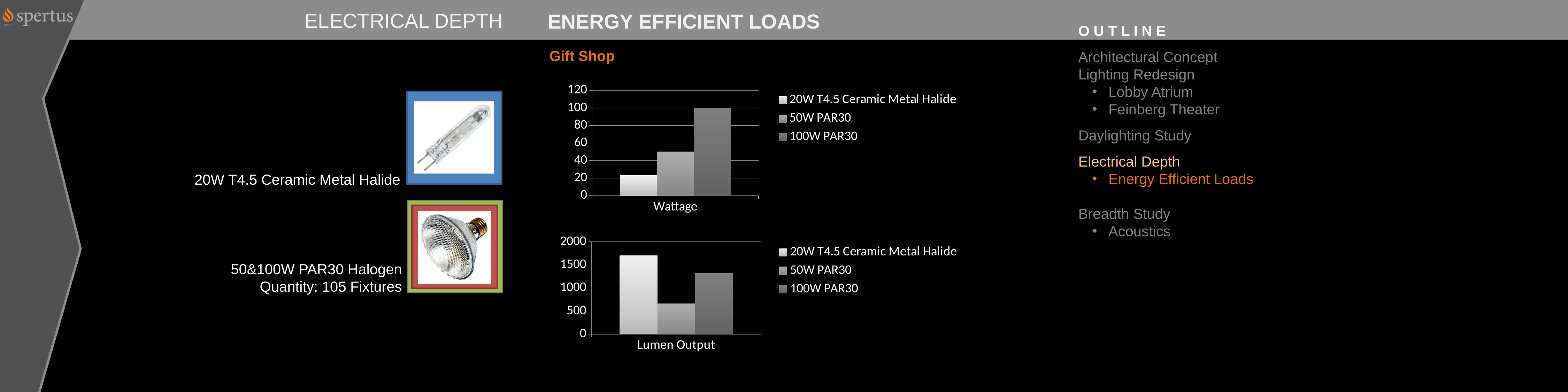
In the Lumen Output chart, which is larger: the value for 100W PAR30 or the value for 50W PAR30? 100W PAR30 In the Wattage chart, what is the value for 100W PAR30? 100 In the Lumen Output chart, is the value for 20W T4.5 Ceramic Metal Halide greater or less than 1500? greater How many series does the legend of the Lumen Output chart list? 3 In the Lumen Output chart, which series has the lowest value? 50W PAR30 In the Wattage chart, which series has the lowest value? 20W T4.5 Ceramic Metal Halide In the Lumen Output chart, is the value for 50W PAR30 greater or less than 1000? less In the Lumen Output chart, which series has the highest value? 20W T4.5 Ceramic Metal Halide What is the orange heading above the two charts? Gift Shop In the Wattage chart, is the value for 50W PAR30 greater or less than 40? greater In the Wattage chart, which series has the highest value? 100W PAR30 What kind of chart is the Wattage chart? bar chart